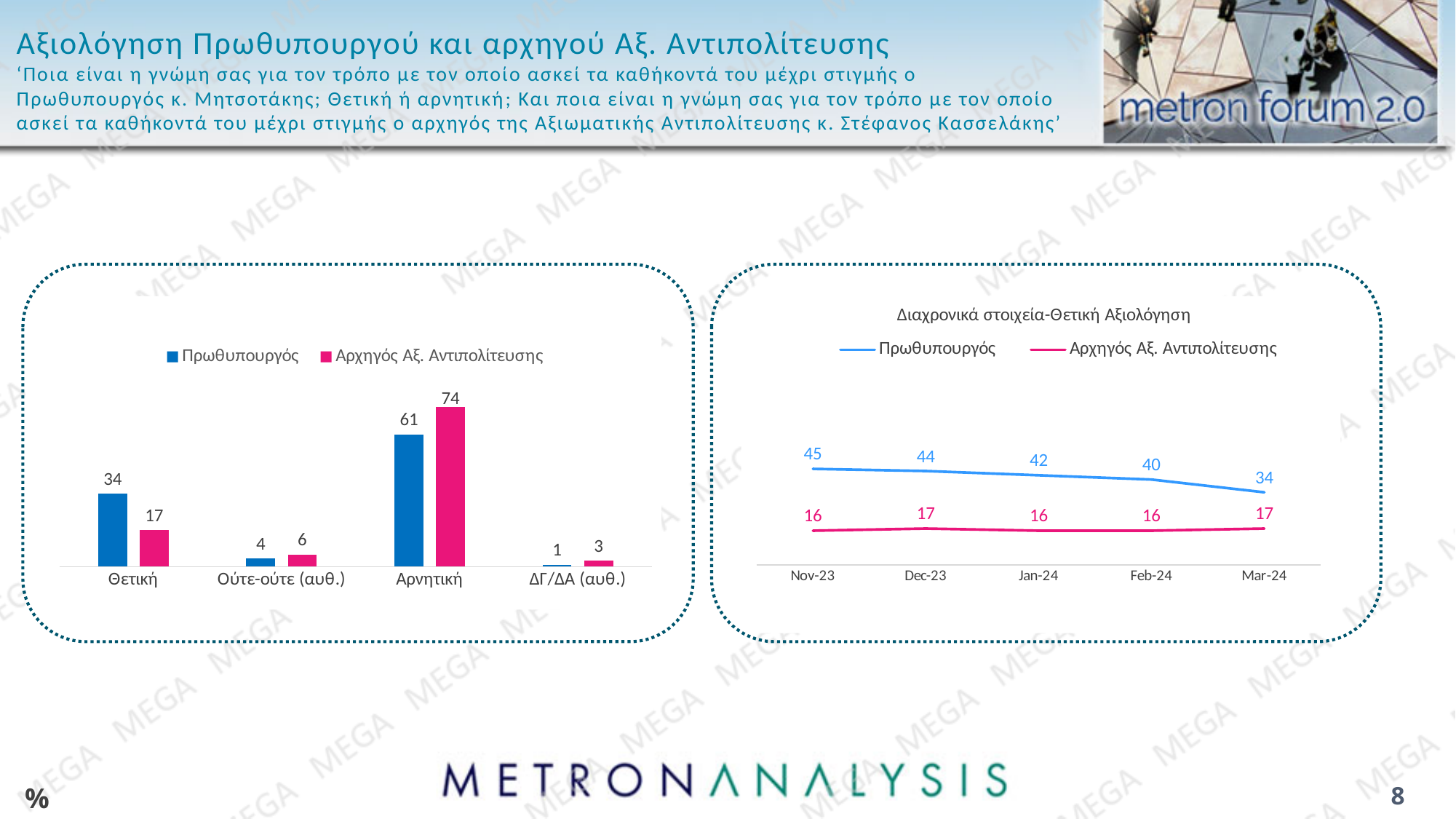
What type of chart is the chart on the left? Bar chart In the bar chart on the left, which series has the larger value in the Θετική category? Πρωθυπουργός In the bar chart on the left, what is the value for Πρωθυπουργός in the Θετική category? 34 In the bar chart on the left, what is the difference between the Αρνητική values for Αρχηγός Αξ. Αντιπολίτευσης and Πρωθυπουργός? 13 How many series does the legend of the chart titled 'Διαχρονικά στοιχεία-Θετική Αξιολόγηση' list? 2 In the bar chart on the left, which category has the highest value for Πρωθυπουργός? Αρνητική In the chart titled 'Διαχρονικά στοιχεία-Θετική Αξιολόγηση', what is the difference between Πρωθυπουργός and Αρχηγός Αξ. Αντιπολίτευσης in Nov-23? 29 In the chart titled 'Διαχρονικά στοιχεία-Θετική Αξιολόγηση', what is the value for Πρωθυπουργός in Mar-24? 34 In the chart titled 'Διαχρονικά στοιχεία-Θετική Αξιολόγηση', does the Πρωθυπουργός line rise or fall from Nov-23 to Mar-24? Fall In the bar chart on the left, which category has the lowest value for Αρχηγός Αξ. Αντιπολίτευσης? ΔΓ/ΔΑ (αυθ.) How many categories are shown on the x axis of the bar chart on the left? 4 In the bar chart on the left, what is the value for Αρχηγός Αξ. Αντιπολίτευσης in the Αρνητική category? 74